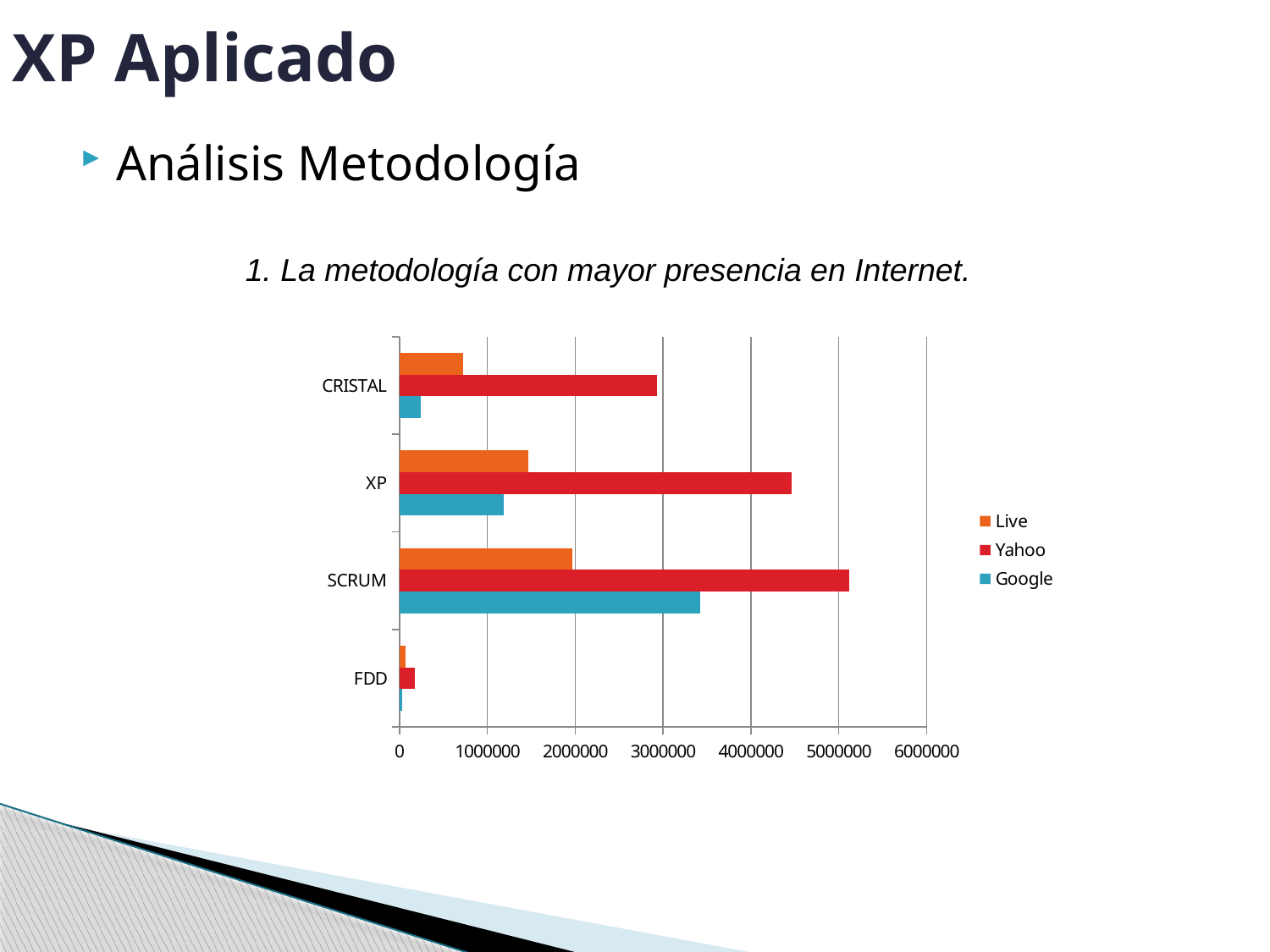
Is the Yahoo value for SCRUM greater or less than 5000000? greater Which methodology has the highest Google value? SCRUM Is the Yahoo value for XP greater or less than 4000000? greater What kind of chart is shown on the slide? bar chart Which series is listed first in the legend? Live Is the Google value for XP greater or less than 2000000? less Which series is shown in red in the legend? Yahoo How many series does the legend list? 3 How many methodology categories are shown on the chart? 4 Which methodology has the highest Yahoo value? SCRUM Which methodology has the lowest Google value? FDD For CRISTAL, which is larger, the Live value or the Google value? Live